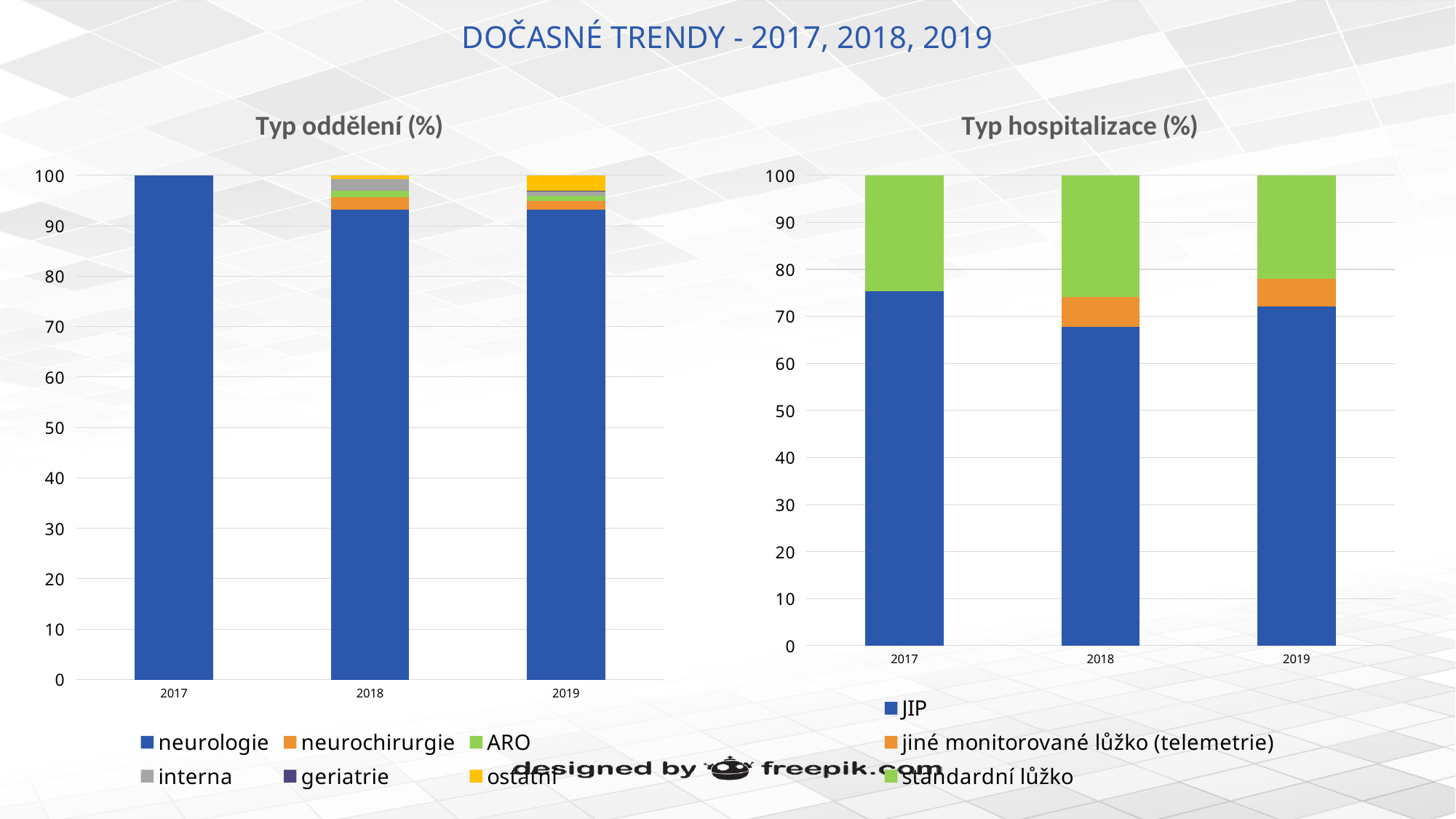
In the "Typ oddělení (%)" chart, what is the value for neurologie in 2017? 100 In the "Typ hospitalizace (%)" chart, which year has the lowest value for JIP? 2018 What kind of chart is the "Typ oddělení (%)" chart? stacked bar chart In the "Typ oddělení (%)" chart, is the value for neurologie in 2018 greater or less than 90? greater In the "Typ hospitalizace (%)" chart, is the value for JIP in 2018 greater or less than 70? less In the "Typ hospitalizace (%)" chart, which is larger: the JIP value for 2017 or for 2018? 2017 In the "Typ oddělení (%)" chart, what is the total of the stacked bar for 2019? 100 How many series does the legend of the "Typ hospitalizace (%)" chart list? 3 In the "Typ hospitalizace (%)" chart, is the value for JIP in 2017 greater or less than 70? greater In the "Typ hospitalizace (%)" chart, which colour represents standardní lůžko? green How many series does the legend of the "Typ oddělení (%)" chart list? 6 How many years are shown on the x axis of the "Typ hospitalizace (%)" chart? 3